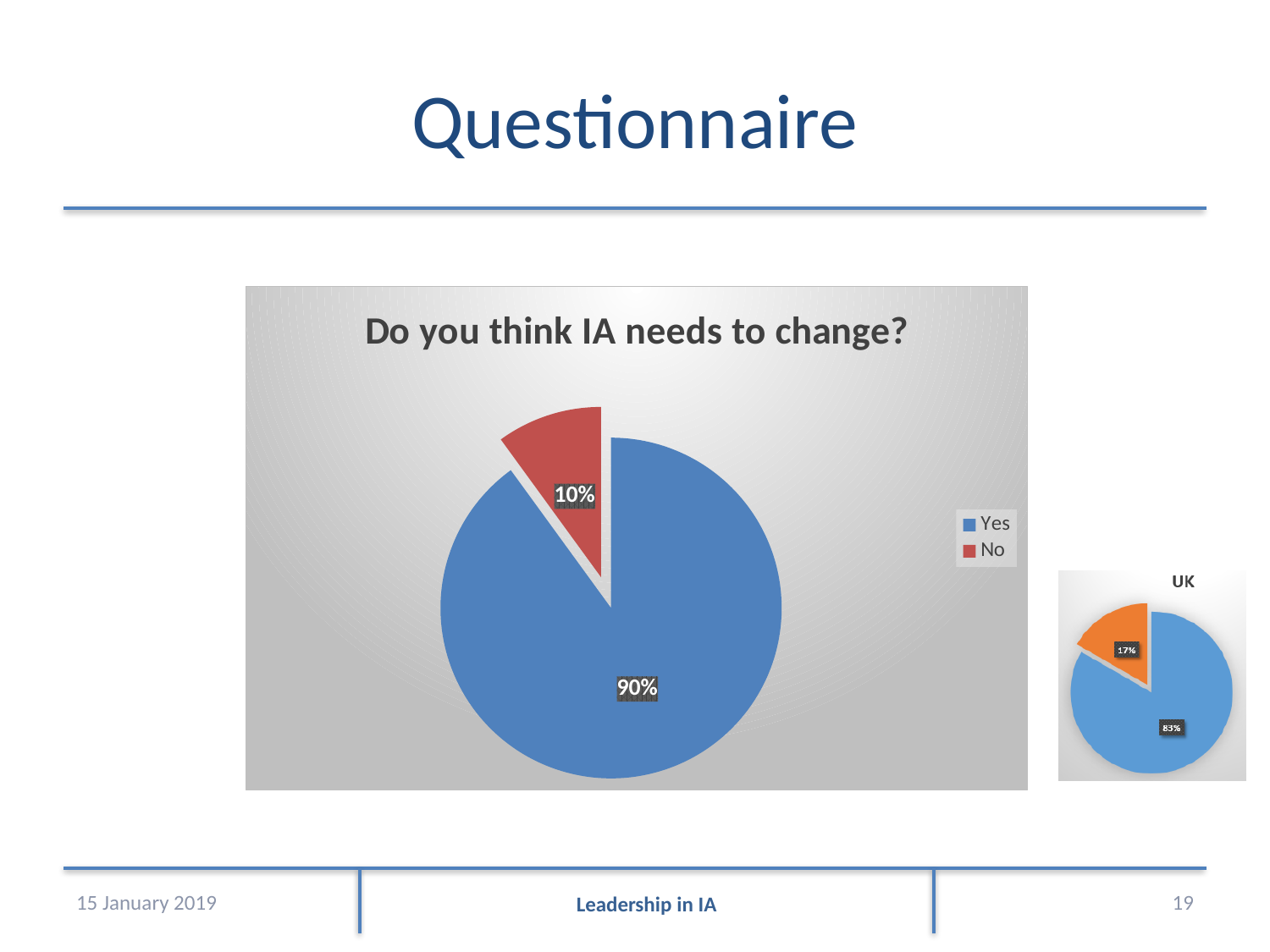
How many entries does the legend of the chart titled "Do you think IA needs to change?" list? 2 What kind of chart is the one titled "Do you think IA needs to change?"? Pie chart In the chart titled "Do you think IA needs to change?", what colour is the Yes slice? Blue In the chart titled "Do you think IA needs to change?", which is larger, the Yes slice or the No slice? Yes In the chart titled "Do you think IA needs to change?", what share of respondents answered No? 10% In the chart titled "Do you think IA needs to change?", what is the difference in percentage points between the Yes and No slices? 80 percentage points In the small chart titled "UK" on the right of the slide, what percentage is shown on the larger slice? 83% In the chart titled "Do you think IA needs to change?", what colour is the No slice? Red In the small chart titled "UK" on the right of the slide, what percentage is shown on the smaller slice? 17% In the chart titled "Do you think IA needs to change?", which response has the largest slice? Yes In the chart titled "Do you think IA needs to change?", which response has the smallest slice? No In the chart titled "Do you think IA needs to change?", what share of respondents answered Yes? 90%